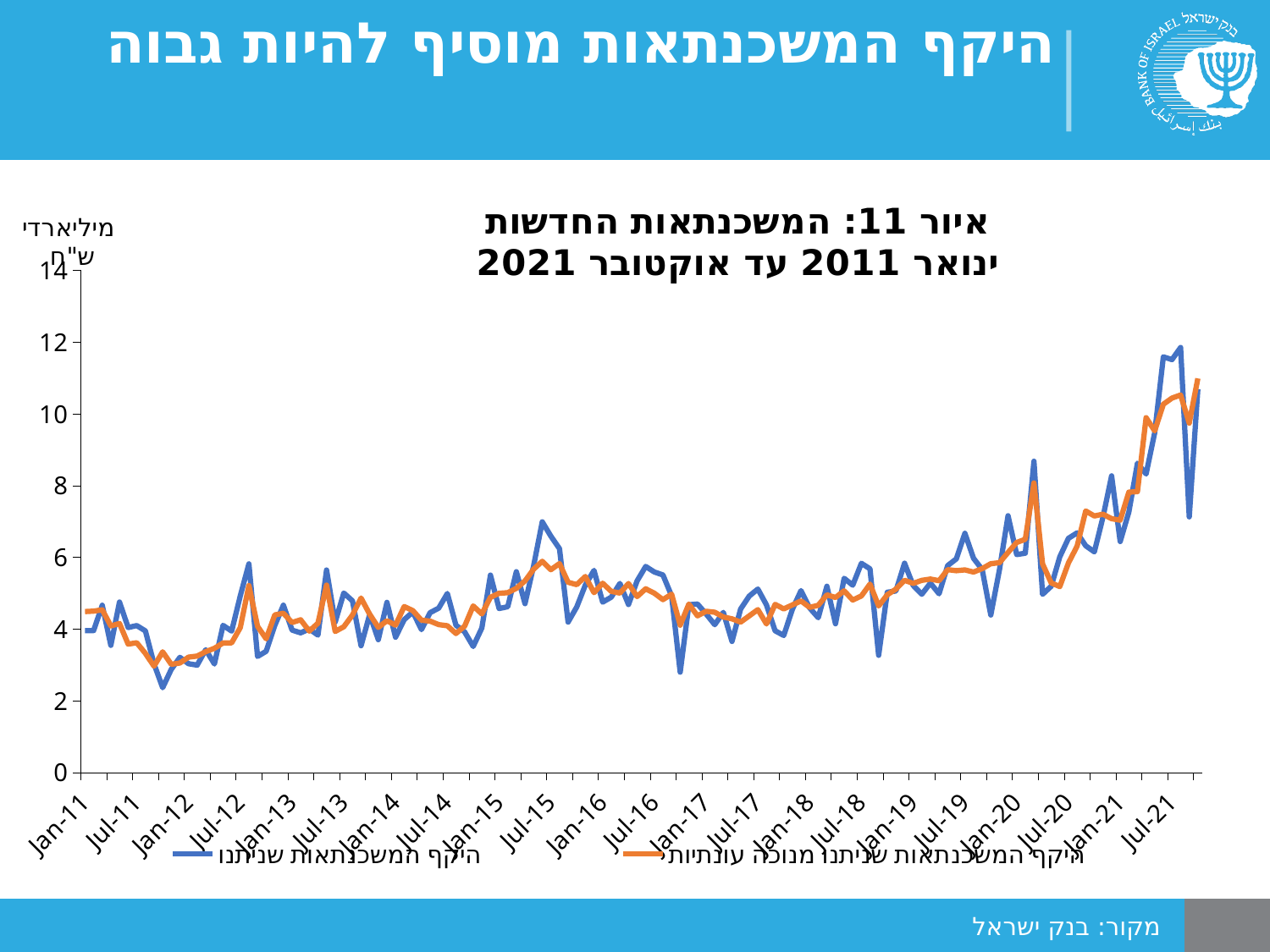
What is the title of the chart? איור 11: המשכנתאות החדשות ינואר 2011 עד אוקטובר 2021 How many labeled tick marks are on the horizontal axis, from Jan-11 to Jul-21? 22 What unit is shown on the vertical axis of the chart? מיליארדי ש"ח Is the value of the blue series at Jan-11 greater or less than 2? greater Is the lowest value of the blue series, near Jan-12, greater or less than 4? less What is the maximum value shown on the vertical axis? 14 Overall, do the values of the blue series rise or fall from Jan-11 to the end of the chart? rise What kind of chart is shown on the slide? line chart Is the value of the orange series (מנוכה עונתיות) at Jan-21 greater or less than 6? greater How many series does the legend list? 2